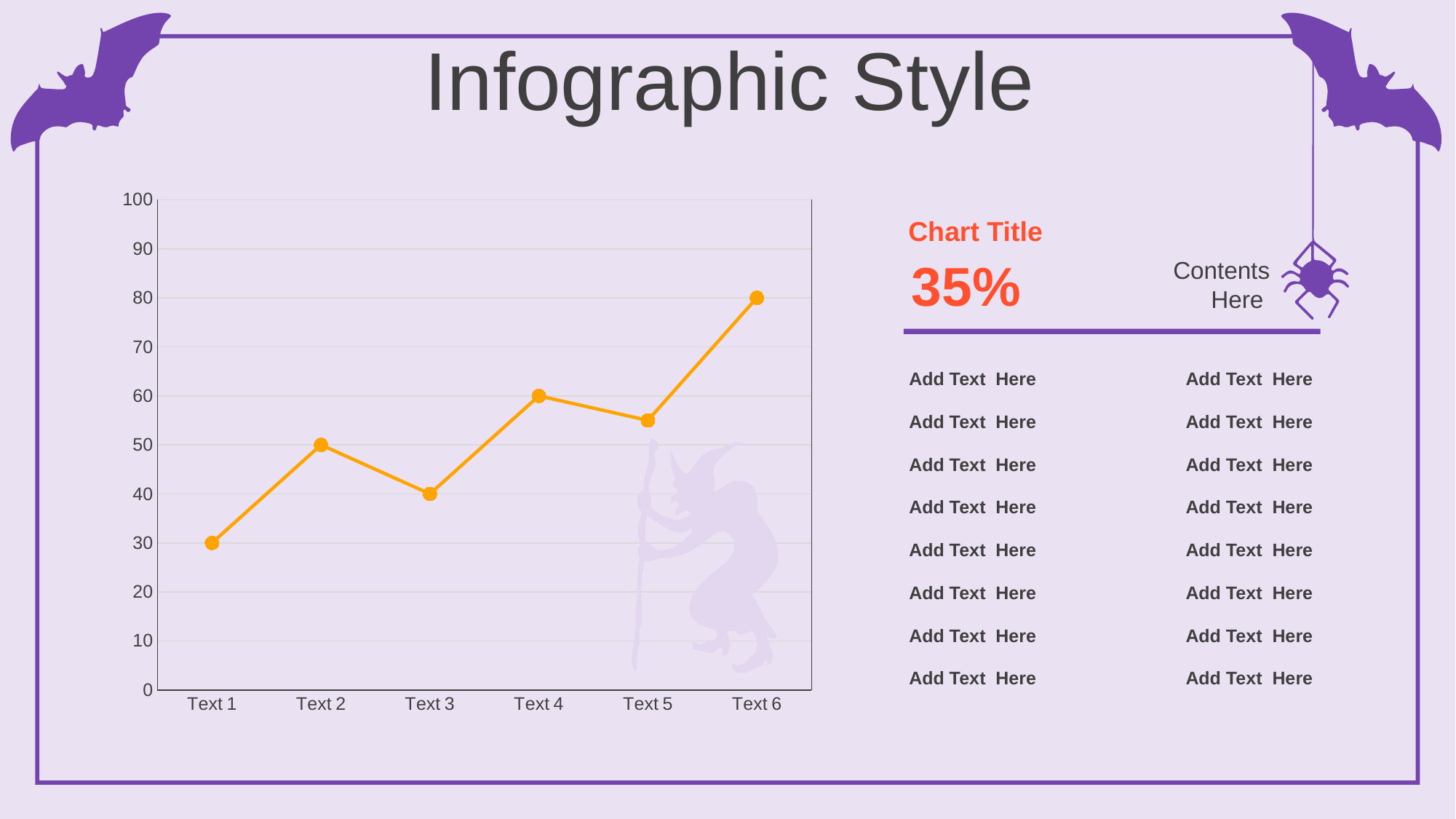
Is the value for Text 5 greater or less than 50? greater Which category has the lowest value in the chart? Text 1 What is the difference between the values for Text 6 and Text 1? 50 Which category has the highest value in the chart? Text 6 How many categories are plotted along the x axis of the chart? 6 What type of chart is shown on the slide? line chart What is the value for Text 2 in the chart? 50 Which is larger, the value for Text 2 or the value for Text 3? Text 2 What is the maximum value shown on the chart's y axis? 100 What is the difference between the values for Text 4 and Text 3? 20 What is the value for Text 6 in the chart? 80 What is the value for Text 1 in the chart? 30